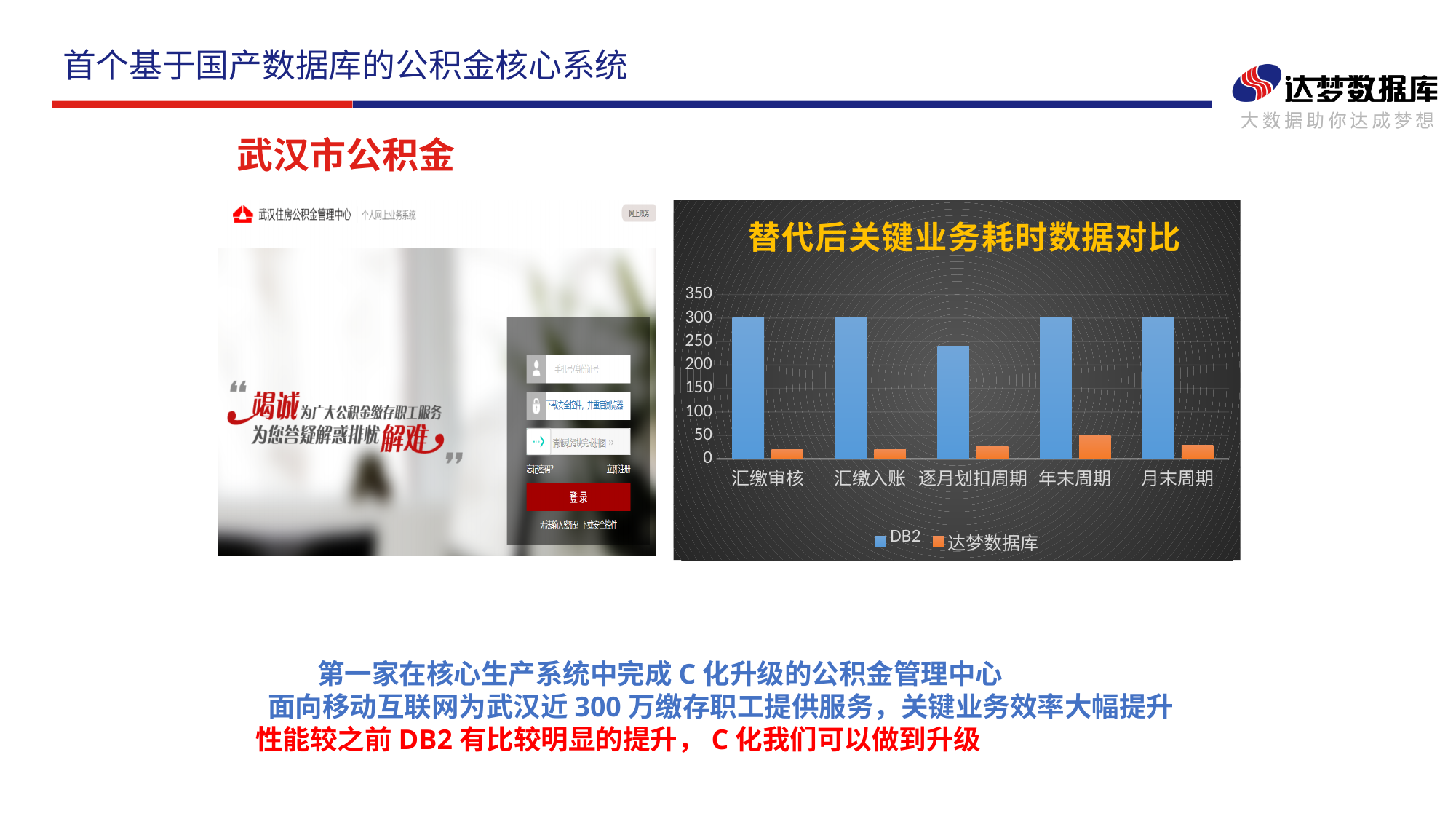
Is the DB2 value for 逐月划扣周期 greater or less than 200? greater How many series does the chart legend list? 2 What kind of chart is shown on the slide? bar chart Which series is drawn in orange in the chart? 达梦数据库 For 汇缴入账, which series has the larger value, DB2 or 达梦数据库? DB2 Which category has the highest 达梦数据库 value in the chart? 年末周期 Is the 达梦数据库 value for 年末周期 greater or less than 100? less Which is larger: the DB2 value for 年末周期 or the DB2 value for 逐月划扣周期? 年末周期 Is the 达梦数据库 value for 汇缴审核 greater or less than 50? less Which category has the lowest DB2 value in the chart? 逐月划扣周期 What is the title of the chart? 替代后关键业务耗时数据对比 How many categories are shown on the x axis of the chart? 5